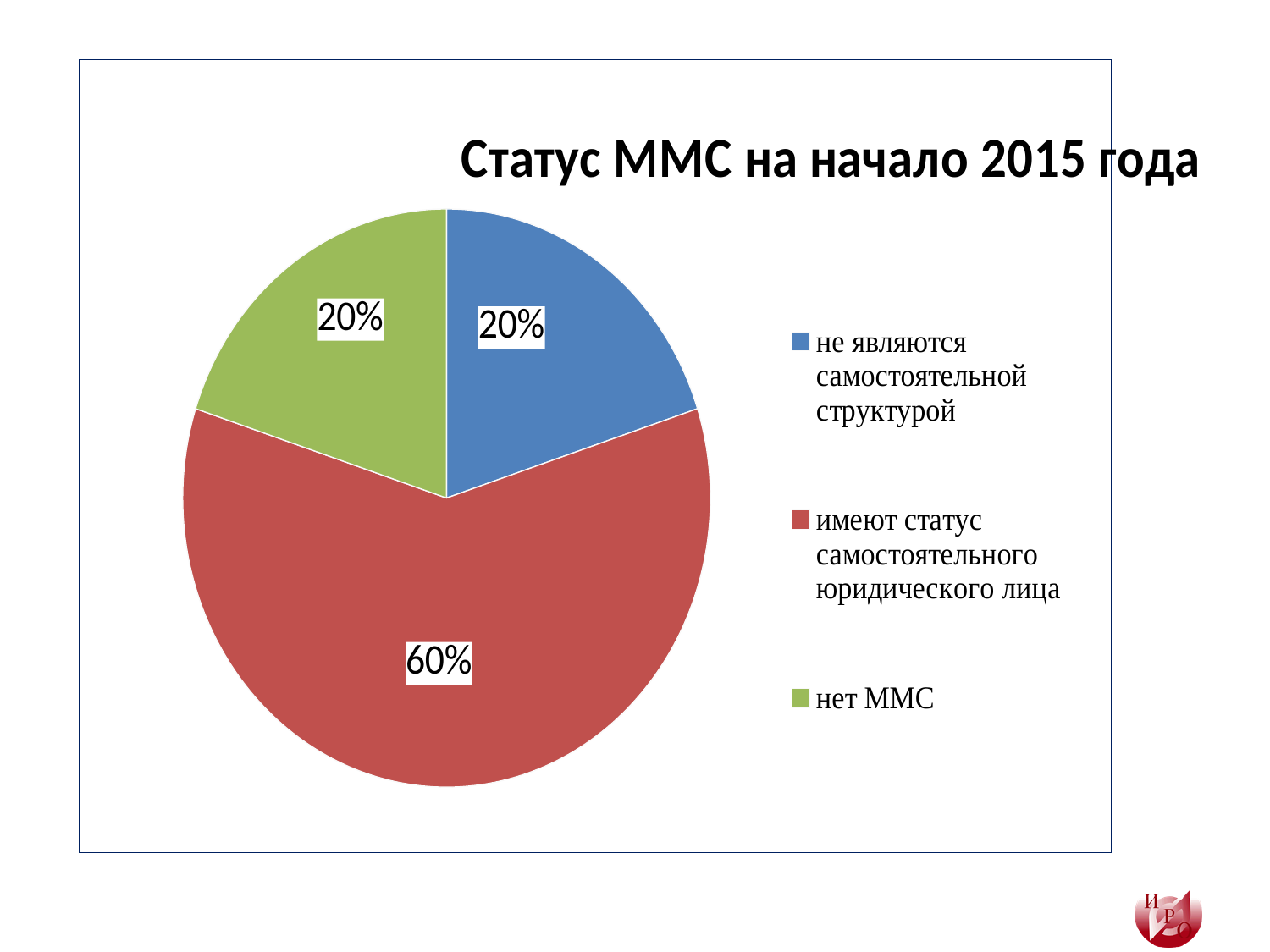
What share of the pie is labelled "имеют статус самостоятельного юридического лица"? 60% What is the difference between the share for "имеют статус самостоятельного юридического лица" and the share for "нет ММС"? 40% What share of the pie is labelled "нет ММС"? 20% What share of the pie is labelled "не являются самостоятельной структурой"? 20% Which category has the largest slice of the pie? имеют статус самостоятельного юридического лица What is the title of the chart? Статус ММС на начало 2015 года How many entries does the legend list? 3 Which is larger: the share for "имеют статус самостоятельного юридического лица" or the share for "не являются самостоятельной структурой"? имеют статус самостоятельного юридического лица What colour is the slice for "нет ММС"? green What is the combined share of "не являются самостоятельной структурой" and "нет ММС"? 40% What type of chart is shown on the slide? pie chart How many slices does the pie chart have? 3